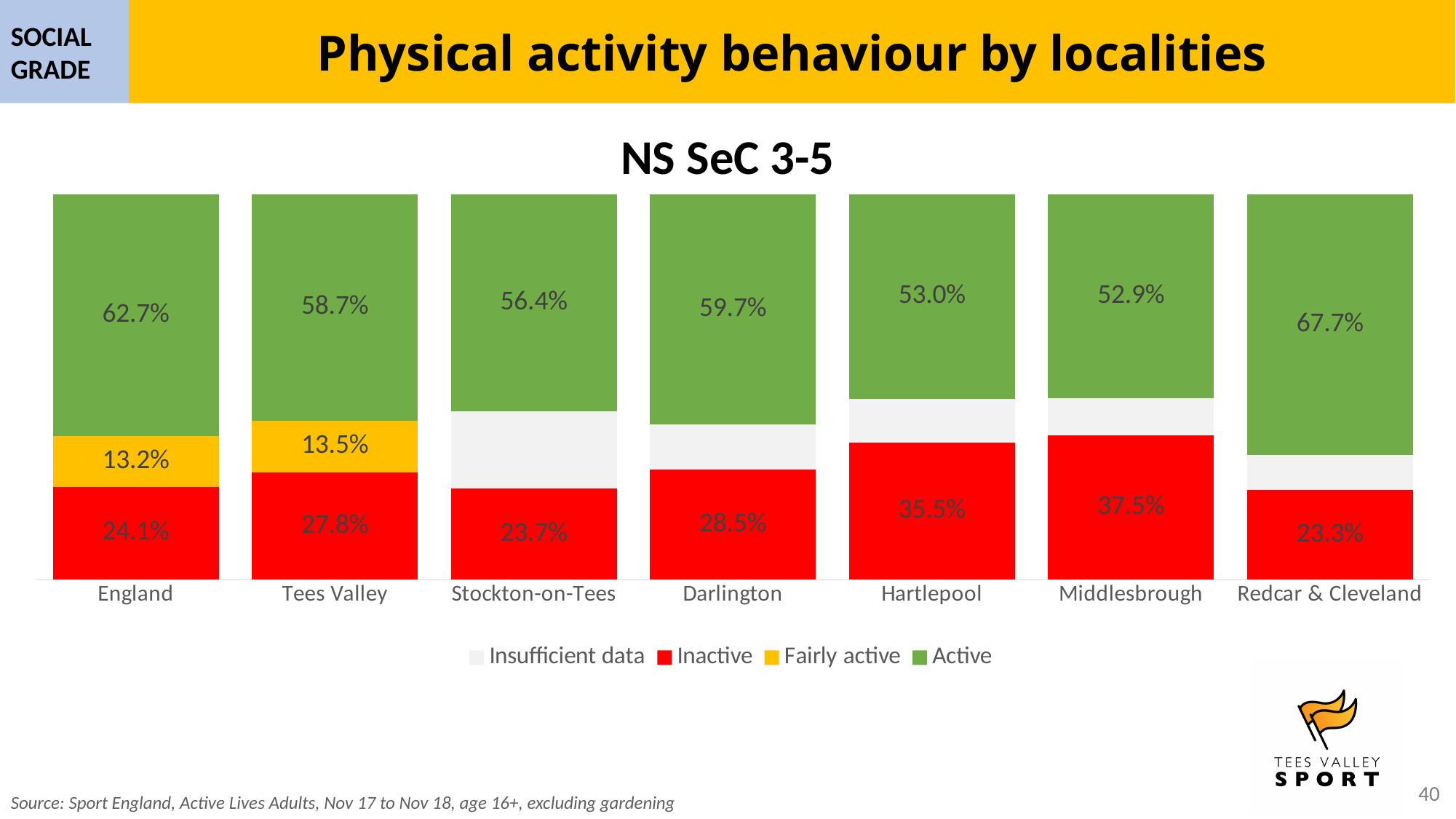
How many localities are shown on the x axis? 7 What kind of chart is shown? Stacked bar chart Which locality has the highest Active percentage? Redcar & Cleveland How many series does the legend list? 4 What is the Inactive percentage for Hartlepool? 35.5% What is the total of the three labelled segments (Inactive, Fairly active, Active) for England? 100.0% What is the Fairly active percentage for Tees Valley? 13.5% What is the difference in Active percentage between Redcar & Cleveland and Middlesbrough? 14.8 percentage points What is the title of the chart? NS SeC 3-5 Which has a higher Inactive percentage, Darlington or Stockton-on-Tees? Darlington Which locality has the highest Inactive percentage? Middlesbrough What is the Active percentage for Redcar & Cleveland? 67.7%